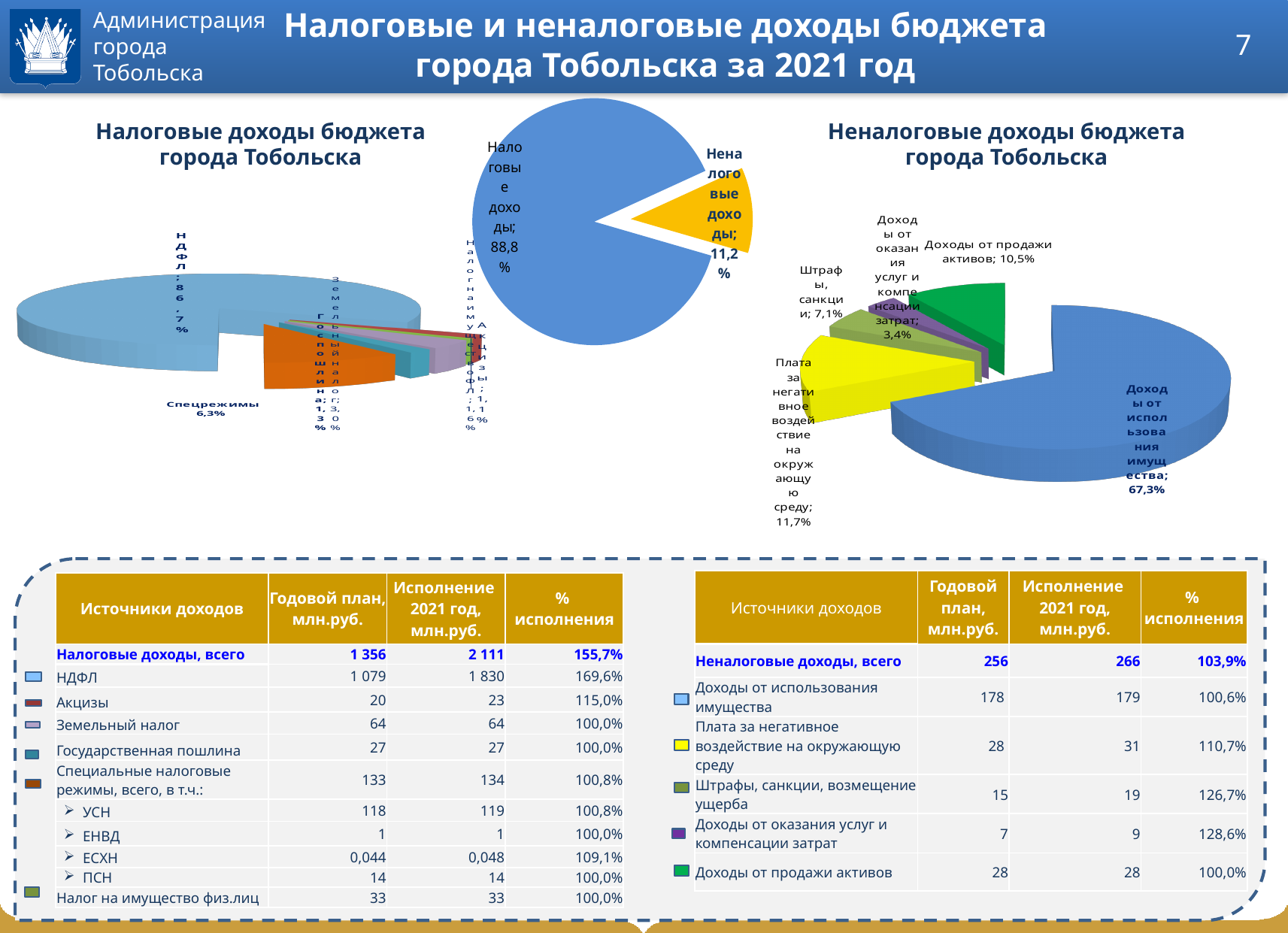
In the chart 'Неналоговые доходы бюджета города Тобольска', what share do Доходы от продажи активов have? 10,5% In the chart 'Неналоговые доходы бюджета города Тобольска', what share do Доходы от использования имущества have? 67,3% In the chart 'Налоговые доходы бюджета города Тобольска', what share do Спецрежимы have? 6,3% What kind of chart is 'Неналоговые доходы бюджета города Тобольска'? Pie chart In the chart 'Неналоговые доходы бюджета города Тобольска', which is larger: Плата за негативное воздействие на окружающую среду or Штрафы, санкции? Плата за негативное воздействие на окружающую среду In the chart 'Неналоговые доходы бюджета города Тобольска', which category has the smallest slice? Доходы от оказания услуг и компенсации затрат In the centre pie chart, how many slices are there? 2 In the chart 'Налоговые доходы бюджета города Тобольска', what is the difference between the shares of НДФЛ and Спецрежимы? 80,4% In the chart 'Налоговые доходы бюджета города Тобольска', which category has the largest slice? НДФЛ